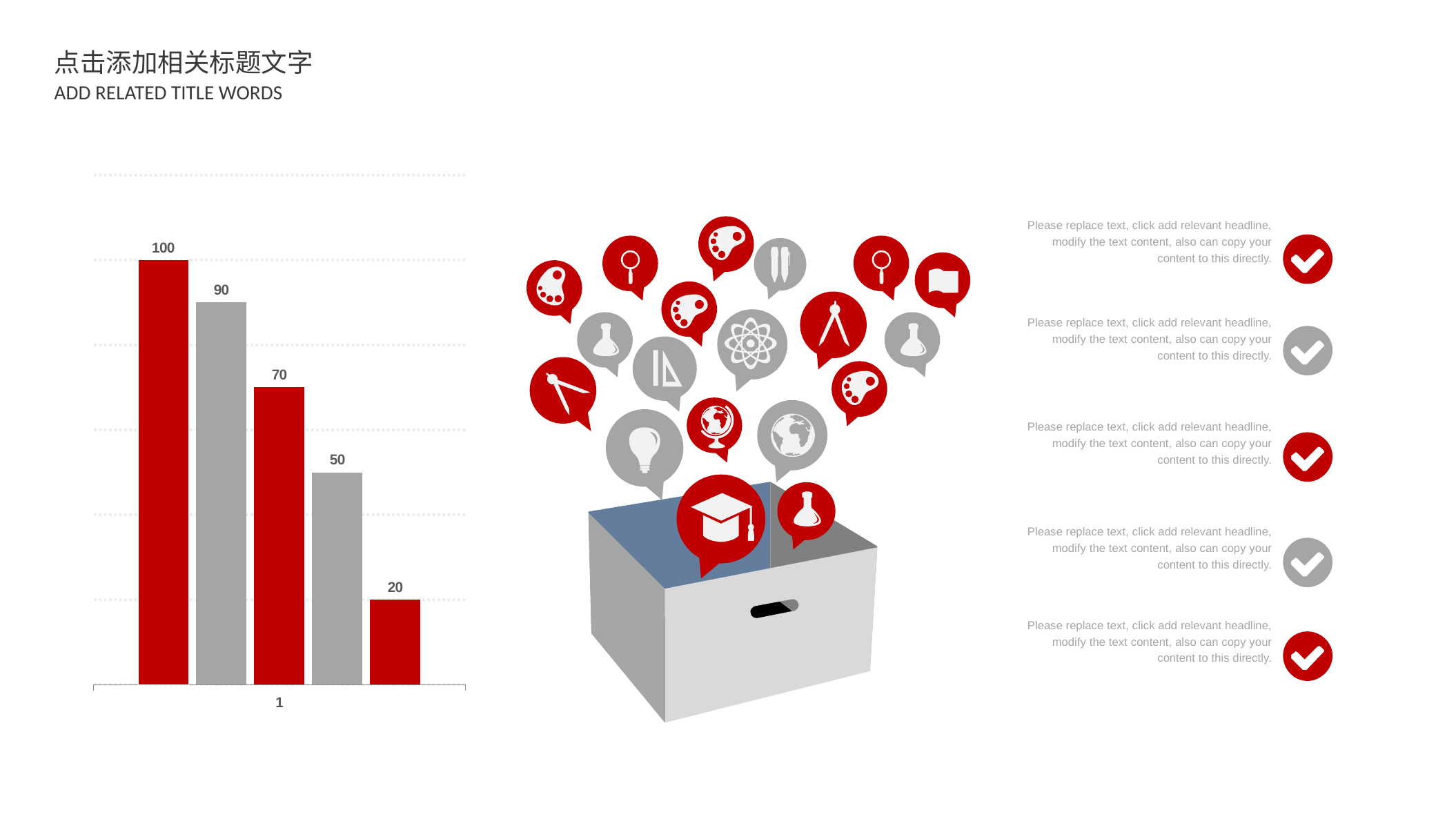
What is the value shown on the last (rightmost) bar of the chart? 20 What is the value shown on the first (leftmost) bar of the chart? 100 What category label is shown on the x axis of the bar chart? 1 What is the difference between the first bar (100) and the fourth bar (50)? 50 What is the value shown on the third bar of the chart? 70 Do the bar values rise or fall from left to right across the chart? fall Which is larger, the second bar or the third bar? the second bar (90) What kind of chart is shown on the left of the slide? bar chart What is the value shown on the second bar of the chart? 90 How many bars are plotted in the bar chart? 5 What is the highest value labelled on the bar chart? 100 What is the lowest value labelled on the bar chart? 20